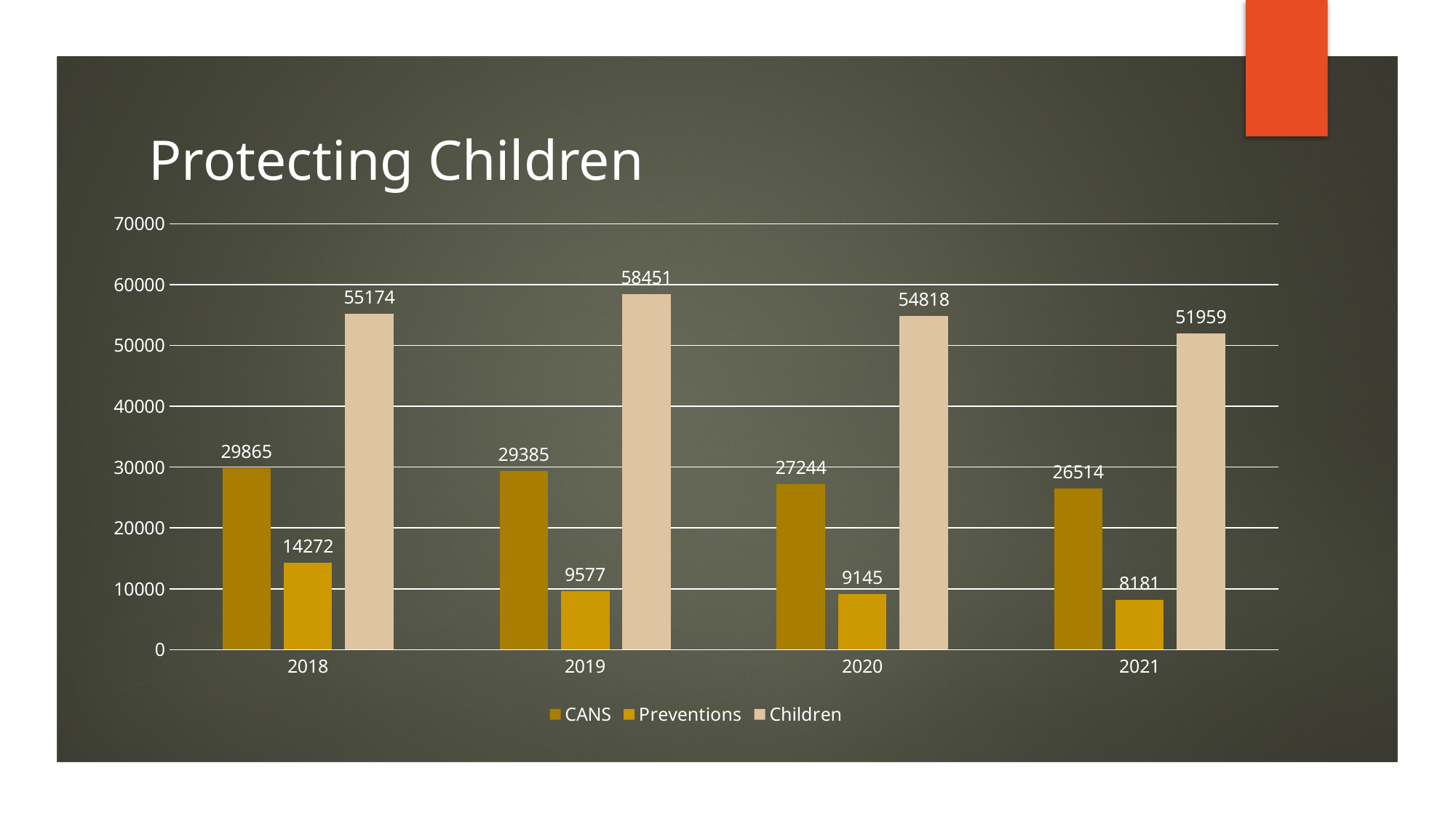
How many series does the legend list? 3 Do the CANS values rise or fall from 2018 to 2021? Fall What is the value for Preventions in 2018? 14272 What is the difference between the Children value in 2019 and in 2021? 6492 Which is larger, the CANS value in 2019 or the CANS value in 2020? CANS in 2019 How many years are shown on the x axis? 4 In which year is the Preventions value lowest? 2021 What kind of chart is shown on the slide? Bar chart In which year is the Children value highest? 2019 What is the value for Children in 2019? 58451 What is the CANS value for 2021? 26514 What is the difference between the CANS value in 2018 and the Preventions value in 2018? 15593